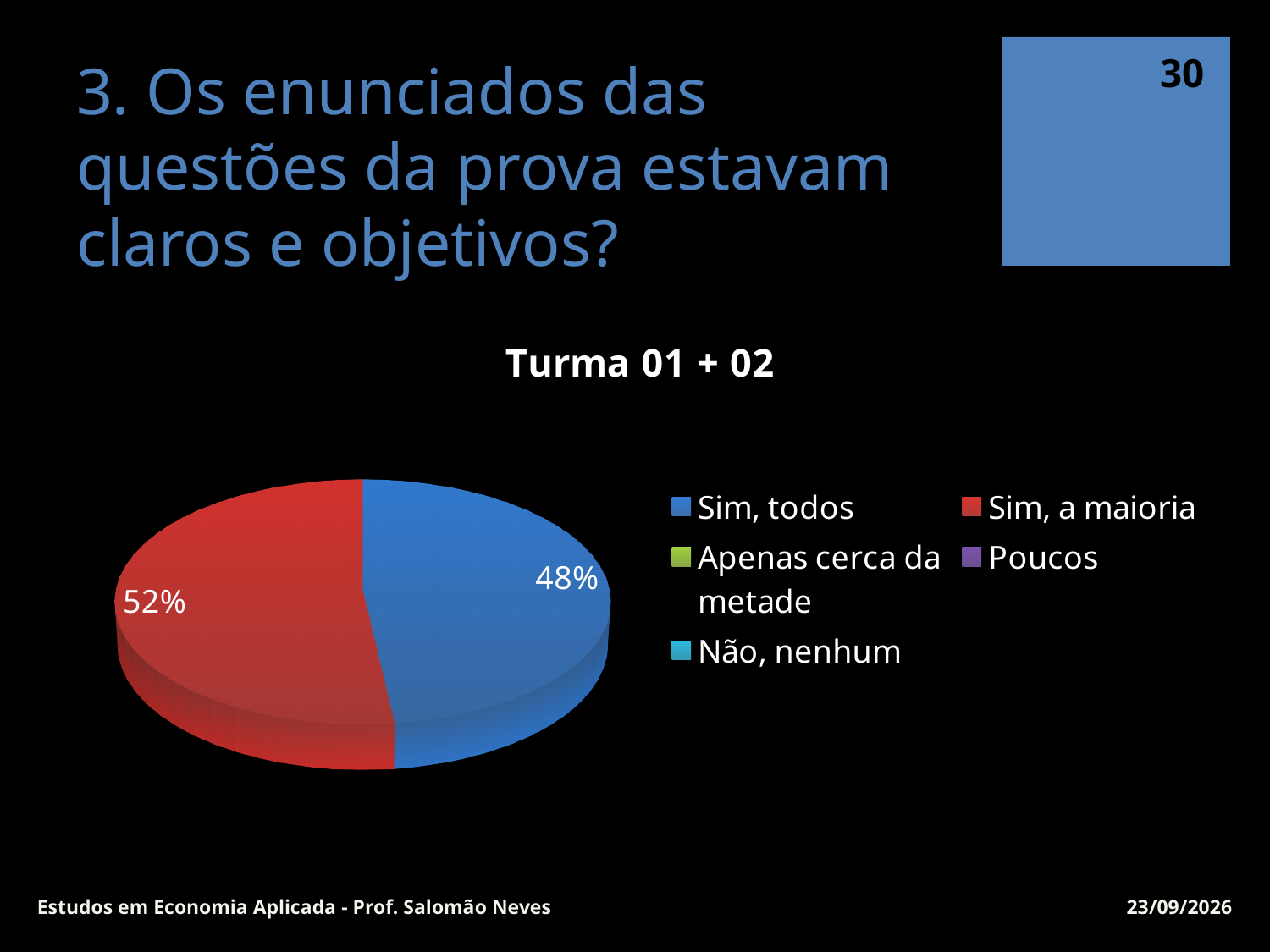
What colour is the "Sim, a maioria" slice? red Is the share for "Sim, todos" greater or less than 50%? less What type of chart is shown on the slide? pie chart What is the combined share of the "Sim, todos" and "Sim, a maioria" slices? 100% How many entries does the legend list? 5 What share of the pie does "Sim, todos" represent? 48% Which category has the largest slice of the pie? Sim, a maioria Which of the two visible slices is smaller, "Sim, todos" or "Sim, a maioria"? Sim, todos What share of the pie does "Sim, a maioria" represent? 52% What is the difference in percentage points between the "Sim, a maioria" slice and the "Sim, todos" slice? 4 percentage points What is the title of the chart? Turma 01 + 02 How many slices with a visible data label does the pie chart have? 2